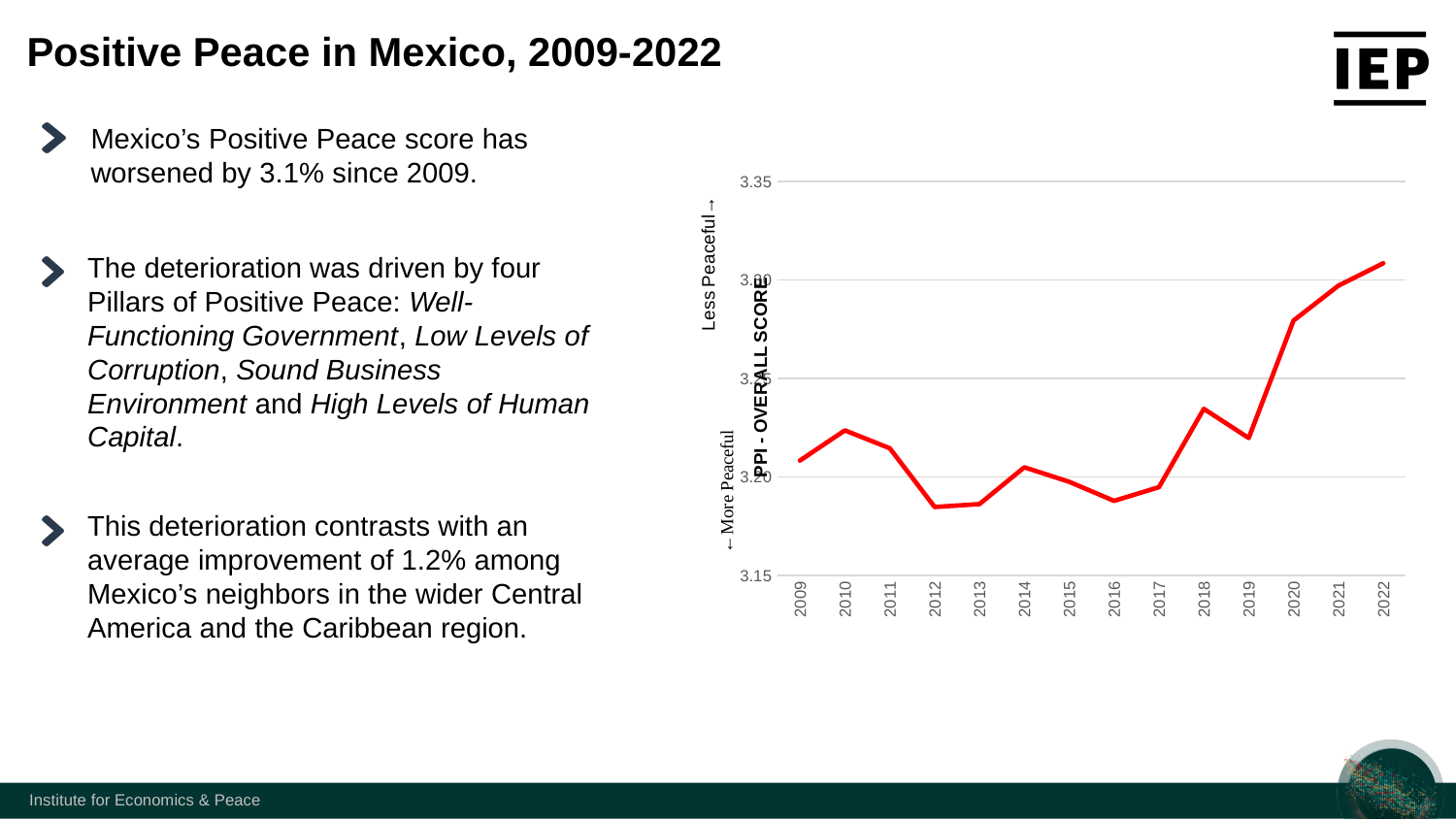
How many years are plotted on the x axis of the chart? 14 Overall, does the PPI overall score rise or fall between 2009 and 2022? rise Is the value for 2018 greater or less than 3.25? less What kind of chart is shown on the slide? line chart Is the value for 2022 greater or less than 3.30? greater Which year has the higher PPI overall score, 2018 or 2020? 2020 In which year is the PPI overall score highest? 2022 Is the value for 2012 greater or less than 3.20? less What is the title of the chart's vertical axis? PPI - OVERALL SCORE Which year has the higher PPI overall score, 2010 or 2012? 2010